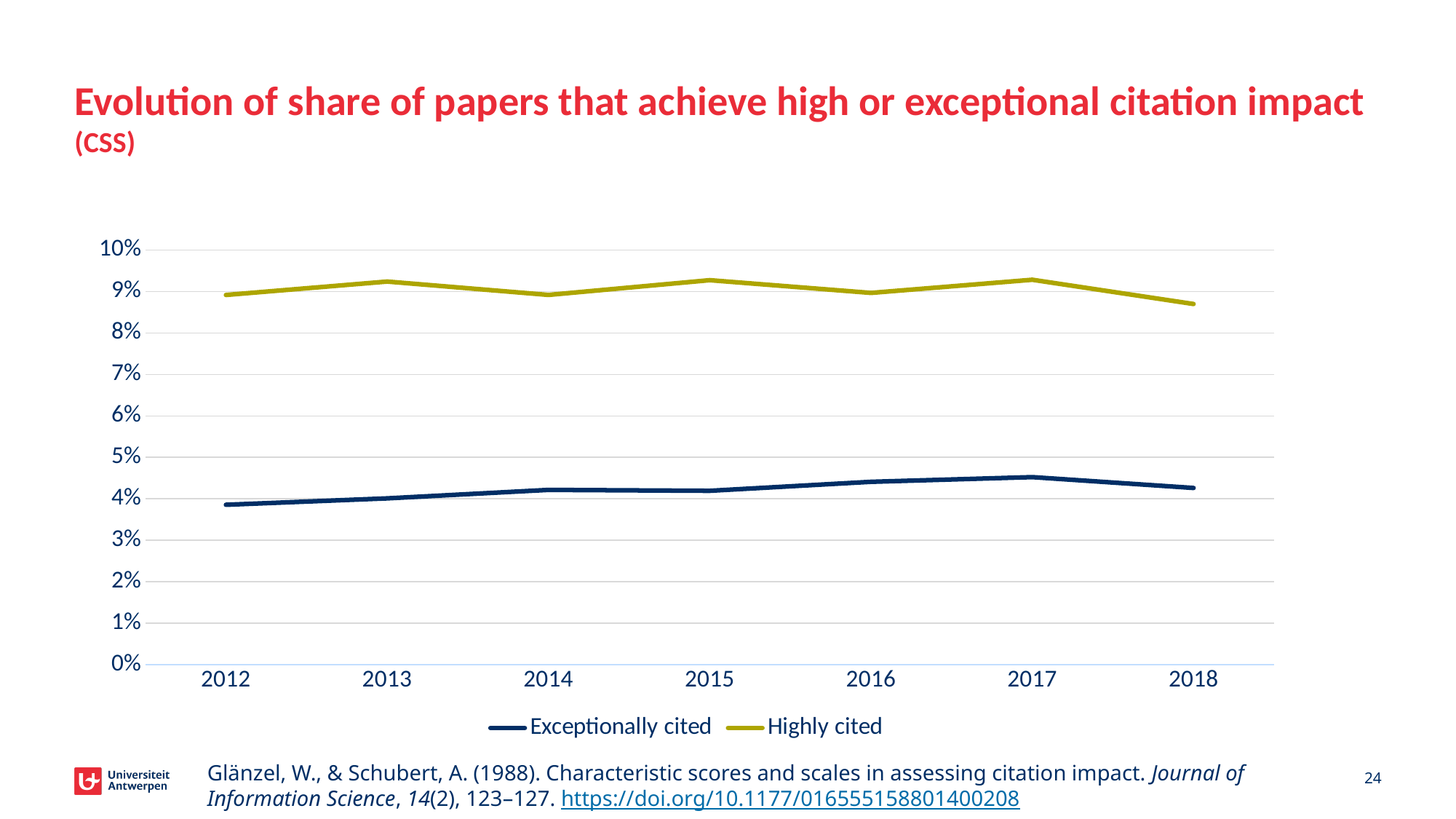
In which year is the Exceptionally cited series at its lowest? 2012 Is the value for Highly cited in 2018 greater or less than 9%? less Is the value for Highly cited in 2012 greater or less than 8%? greater Does the Exceptionally cited series generally rise or fall from 2012 to 2017? rise What kind of chart is shown on the slide? line chart How many series does the legend list? 2 Which series has the higher value in 2015, Exceptionally cited or Highly cited? Highly cited How many years are plotted along the x axis? 7 Is the value for Exceptionally cited in 2012 greater or less than 4%? less What is the title of the chart? Evolution of share of papers that achieve high or exceptional citation impact (CSS) Which year has the larger Exceptionally cited value, 2012 or 2017? 2017